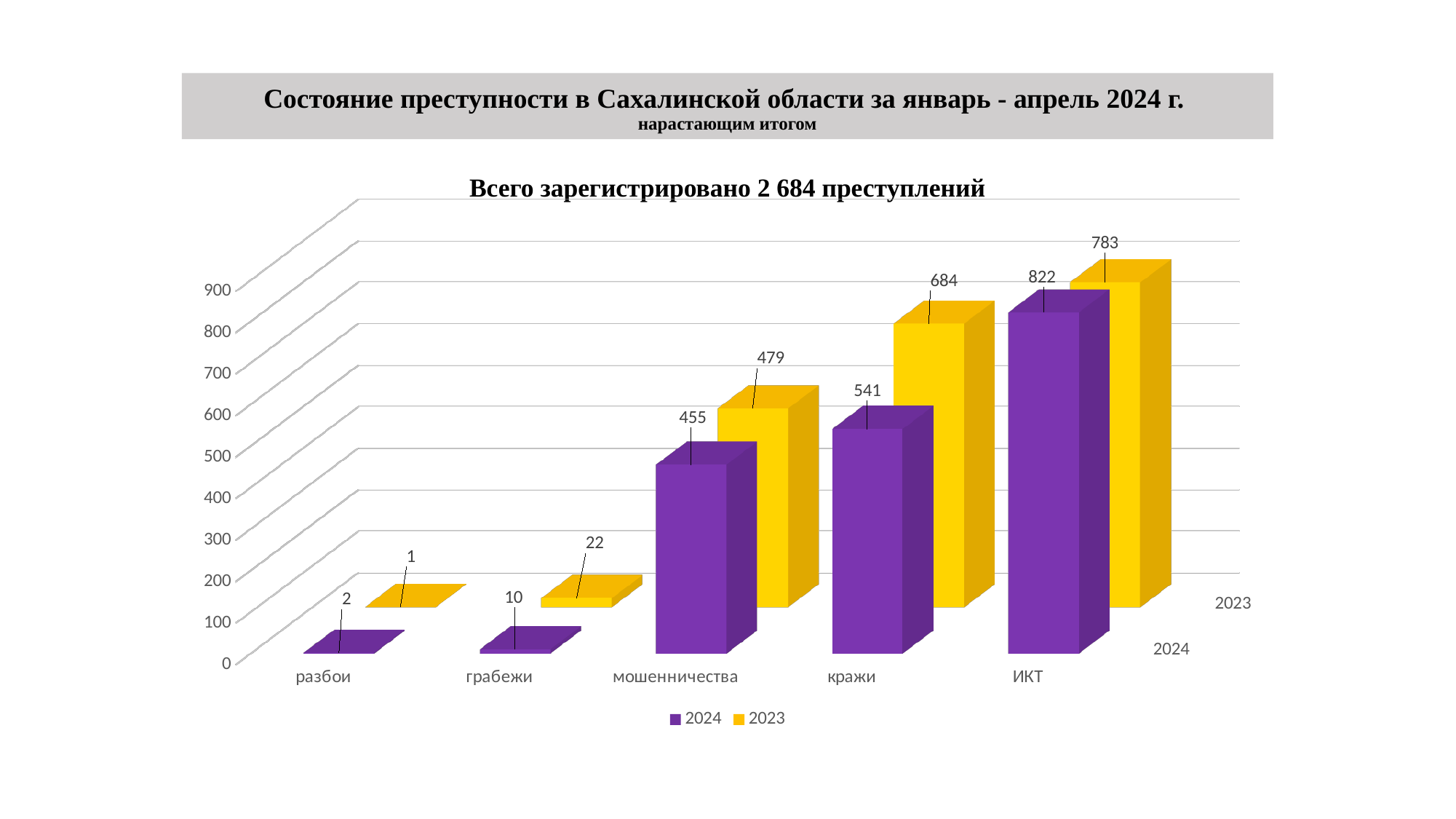
What is the value for кражи in the 2023 series? 684 Which category has the lowest value in the 2024 series? разбои What is the difference between the 2023 and 2024 values for кражи? 143 What is the value for мошенничества in the 2024 series? 455 For ИКТ, which series has the larger value, 2024 or 2023? 2024 What kind of chart is shown on the slide? Bar chart How many categories are shown on the x axis? 5 Which category has the highest value in the 2023 series? ИКТ What is the chart's title? Всего зарегистрировано 2 684 преступлений What is the value for ИКТ in the 2024 series? 822 What is the value for грабежи in the 2023 series? 22 How many series does the legend list? 2